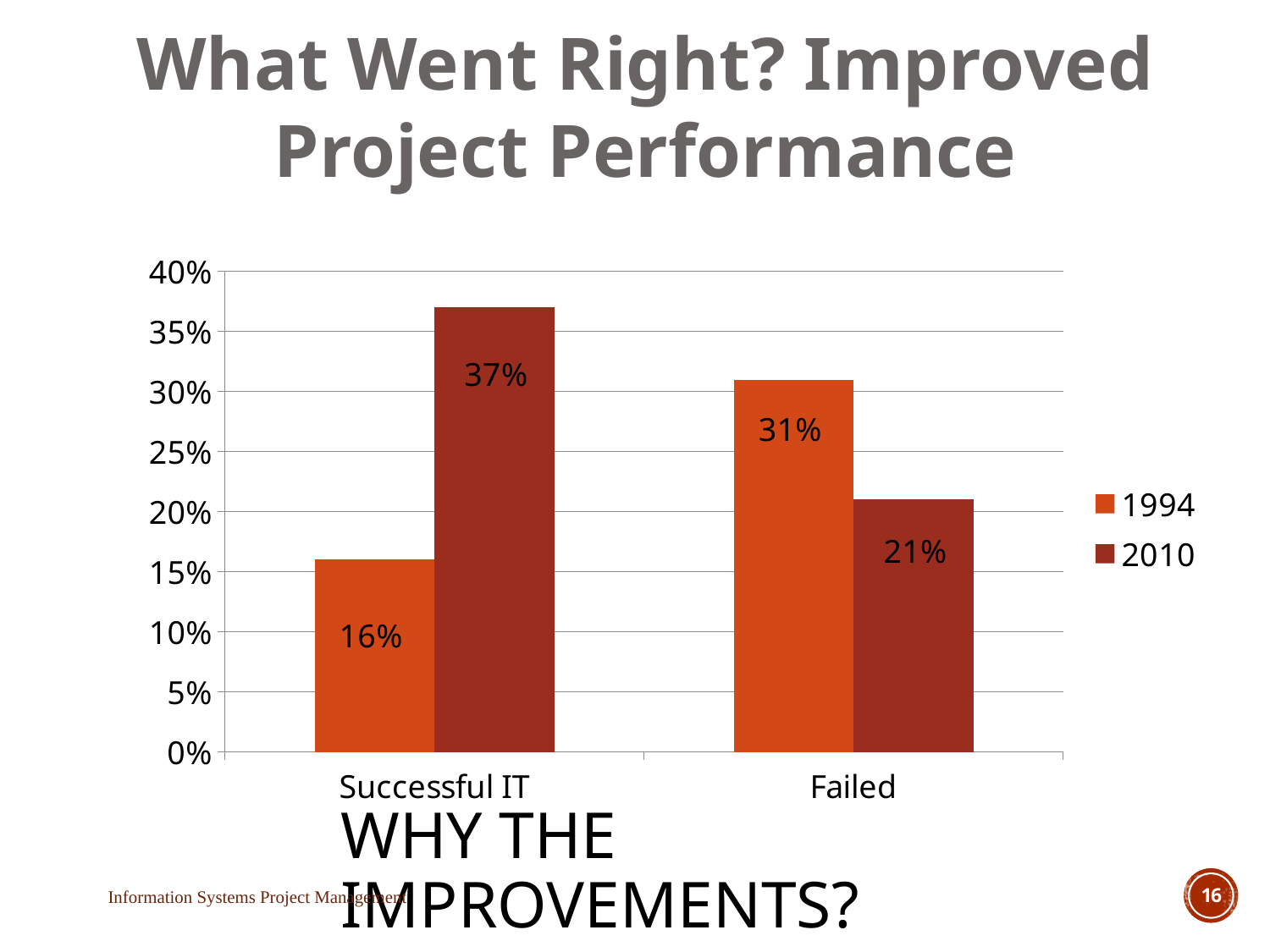
What is the difference between the 2010 and 1994 values for Successful IT? 21% How many series does the legend list? 2 What is the difference between the 1994 and 2010 values for Failed? 10% What is the value for Failed in 2010? 21% What is the value for Successful IT in 2010? 37% How many categories are shown on the x axis? 2 For Failed, which series has the larger value, 1994 or 2010? 1994 Which category has the lowest value in the 1994 series? Successful IT What kind of chart is shown on the slide? Bar chart What is the value for Failed in 1994? 31% What is the value for Successful IT in 1994? 16% Which category has the highest value in the 2010 series? Successful IT